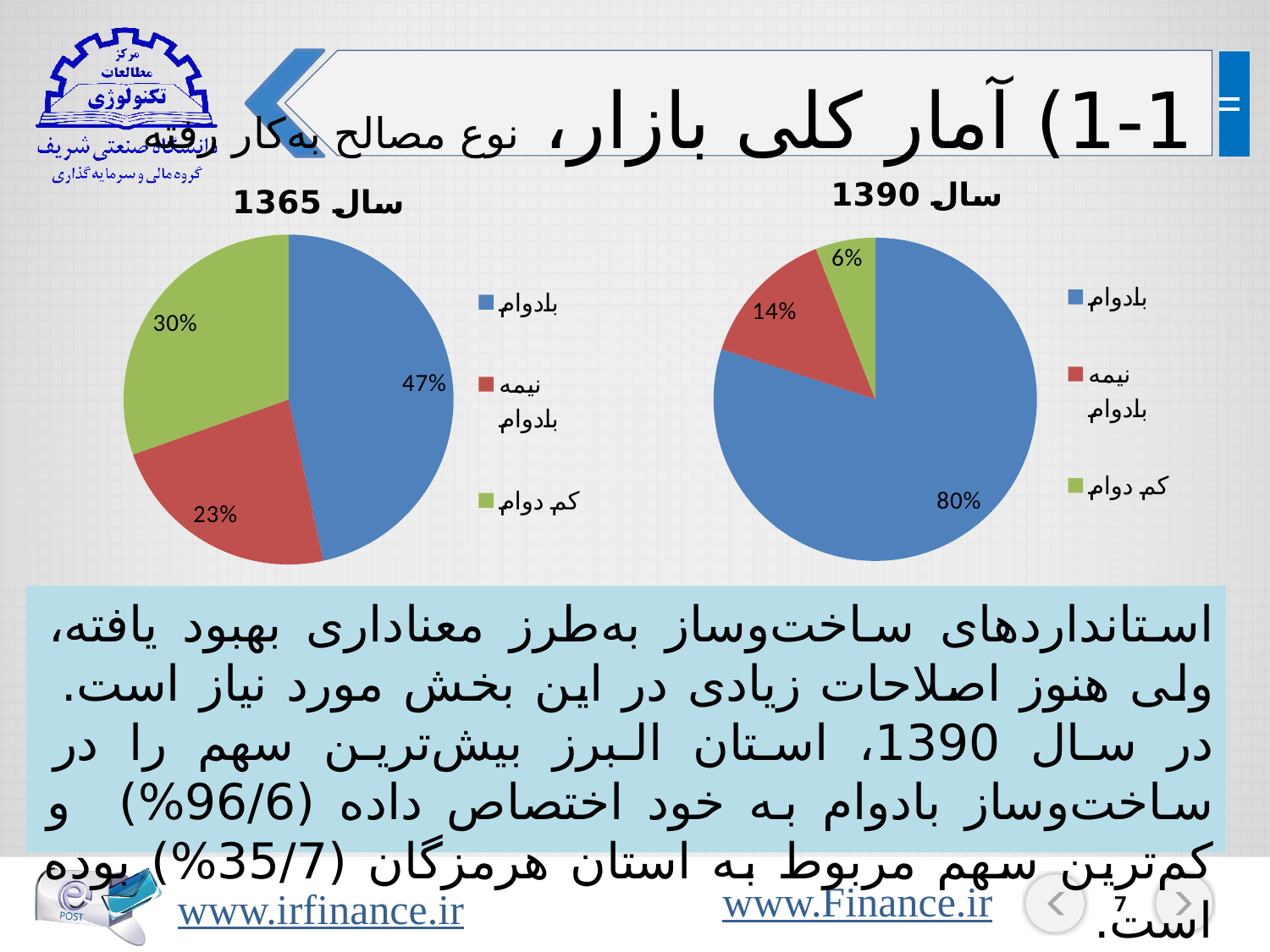
In the chart titled سال 1365, what is the share for نیمه بادوام? 23% In the chart titled سال 1390, what is the share for بادوام? 80% How many categories does the legend of the سال 1390 chart list? 3 In the chart titled سال 1390, what colour is the slice for نیمه بادوام? Red In the chart titled سال 1390, what is the share for کم دوام? 6% In the chart titled سال 1365, which category has the smallest slice? نیمه بادوام In the chart titled سال 1365, what is the share for کم دوام? 30% In the chart titled سال 1390, which category has the largest slice? بادوام In the chart titled سال 1390, which category has the smallest slice? کم دوام In the chart titled سال 1365, which is larger: the share for کم دوام or the share for نیمه بادوام? کم دوام What type of chart is used for سال 1365? Pie chart What is the difference between the بادوام share in the سال 1390 chart and the بادوام share in the سال 1365 chart? 33%